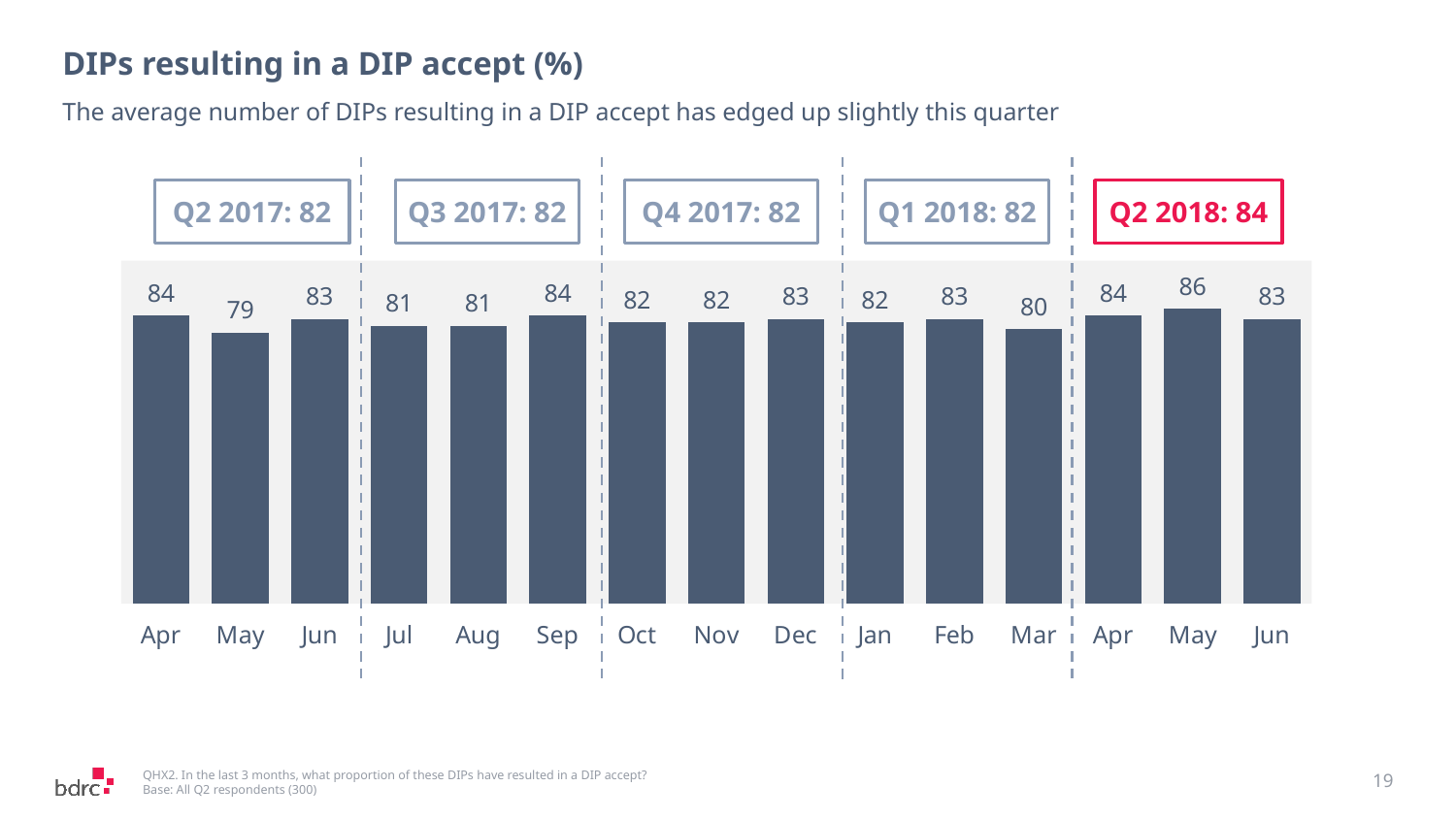
What kind of chart is shown on the slide? Bar chart What is the value for Sep (Q3 2017)? 84 Which month has the lowest value on the chart? May (Q2 2017) How many monthly bars are plotted on the chart? 15 Which is larger, the value for Mar (Q1 2018) or the value for Dec (Q4 2017)? Dec (Q4 2017) What is the value for Mar (Q1 2018)? 80 What is the difference between the Q2 2018 average and the Q1 2018 average? 2 What is the value for May in Q2 2018? 86 What is the quarterly average shown for Q2 2018? 84 Which month has the highest value on the chart? May (Q2 2018) What is the difference between the values for May 2018 and May 2017? 7 What is the title of the chart? DIPs resulting in a DIP accept (%)